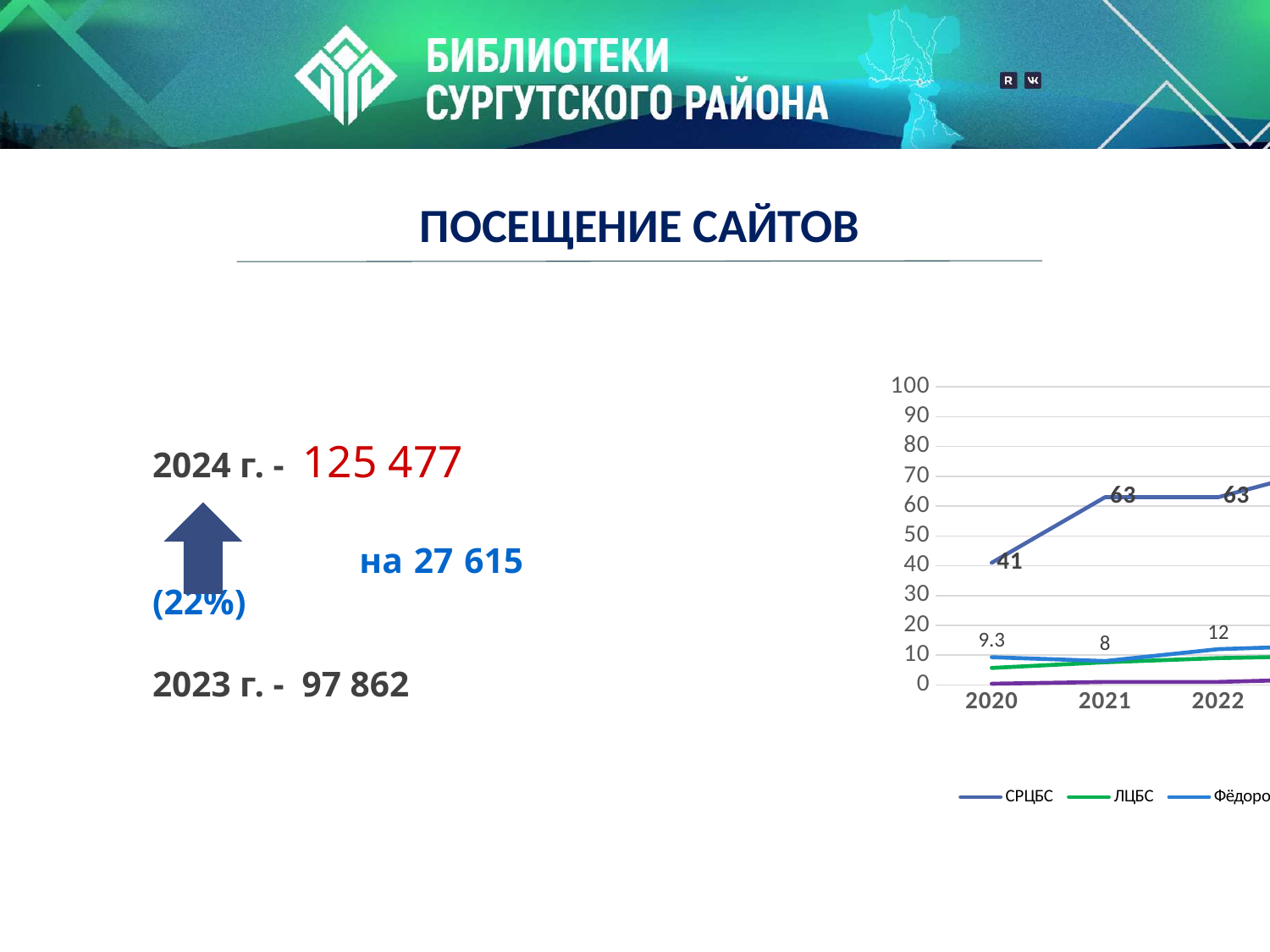
What is the value for СРЦБС in 2022? 63 Does the СРЦБС line rise or fall from 2020 to 2022? rise Is the value for СРЦБС in 2020 greater or less than 50? less Which series is listed first in the chart legend? СРЦБС By how much did the СРЦБС value increase from 2020 to 2021? 22 Is the value for СРЦБС in 2021 greater or less than 50? greater What kind of chart is shown on the right of the slide? line chart Which year has the higher СРЦБС value, 2020 or 2021? 2021 What is the value for СРЦБС in 2021? 63 Is the value for ЛЦБС in 2020 greater or less than 10? less Among 2020, 2021 and 2022, which year has the lowest СРЦБС value? 2020 What is the value for СРЦБС in 2020? 41